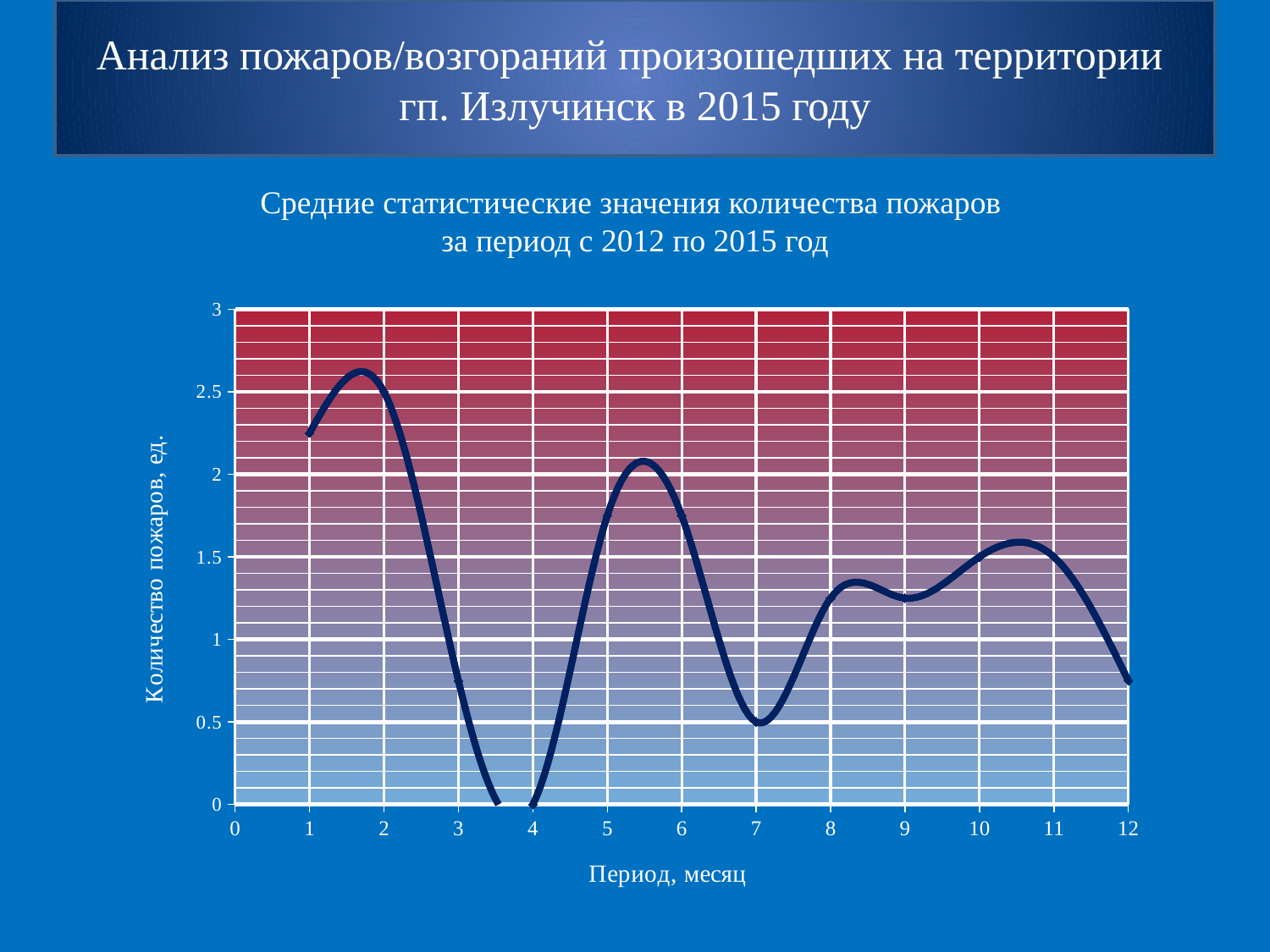
Is the value for month 12 greater or less than 1? less What kind of chart is shown on the slide? line chart What is the title of the chart? Средние статистические значения количества пожаров за период с 2012 по 2015 год Is the value for month 1 greater or less than 2? greater Is the value for month 3 greater or less than 1? less What is the label of the x axis? Период, месяц Which month has the lowest average number of fires? 4 Do the values rise or fall from month 1 to month 4? fall How many months are plotted on the chart? 12 Which has a higher value, month 5 or month 8? month 5 What is the average number of fires in month 4? 0 Which month has the highest average number of fires? 2